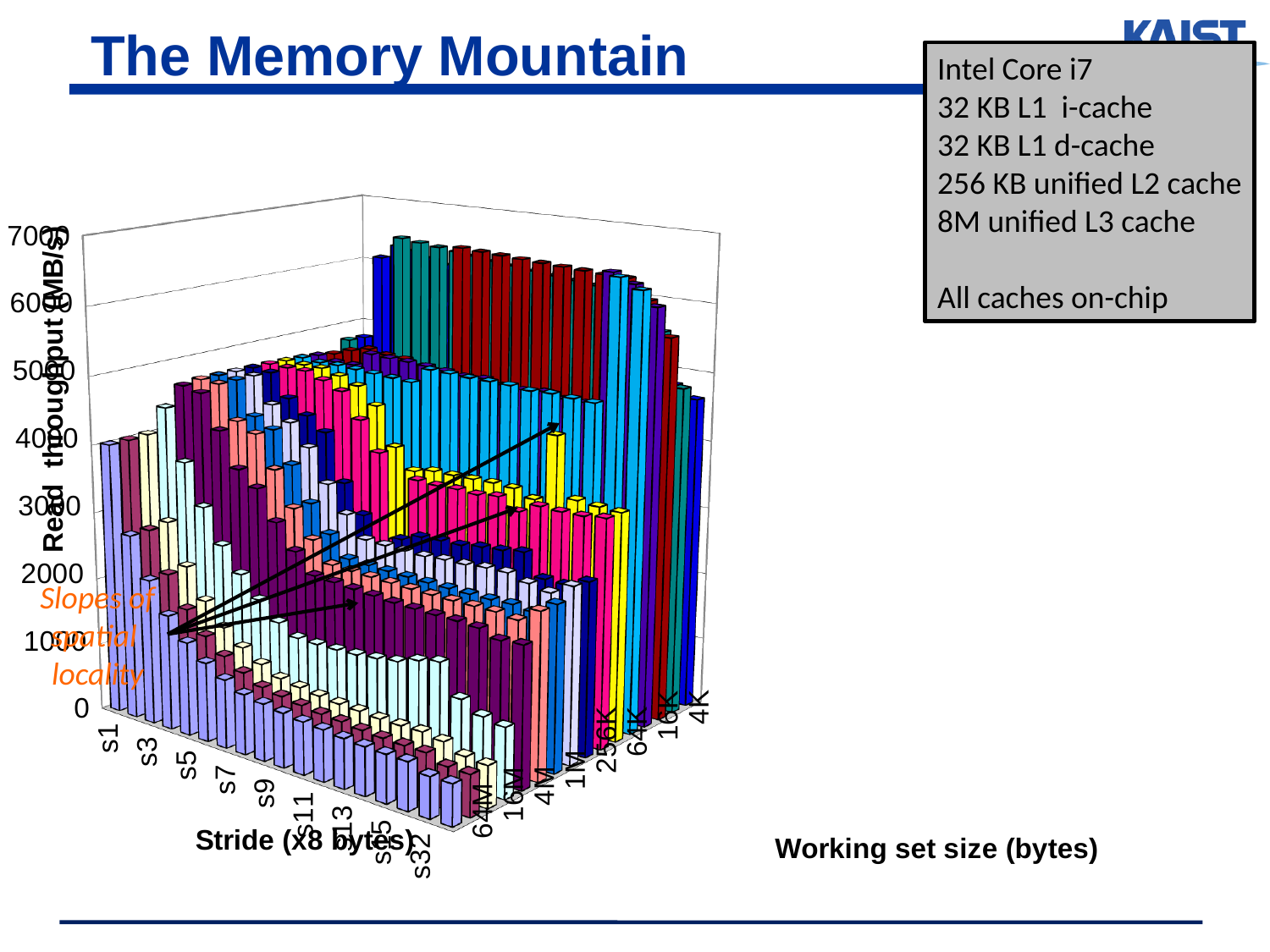
What is the smallest working set size labelled on the chart's axis? 4K What is the lowest value shown on the vertical axis of the chart? 0 Along the stride axis at working set size 64M, does read throughput rise or fall as stride increases from s1 to s32? fall What is the largest working set size labelled on the chart's axis? 64M What is the title of the chart on the slide? The Memory Mountain What is the highest value shown on the vertical axis of the chart? 7000 Is the read throughput for stride s32 at working set size 64M greater or less than 1000? less What kind of chart is shown on the slide? bar chart How many working set size labels are shown along the depth axis of the chart? 8 What is the label of the vertical axis of the chart? Read throughput (MB/s) Which working set size has the higher read throughput at stride s1: 4K or 64M? 4K